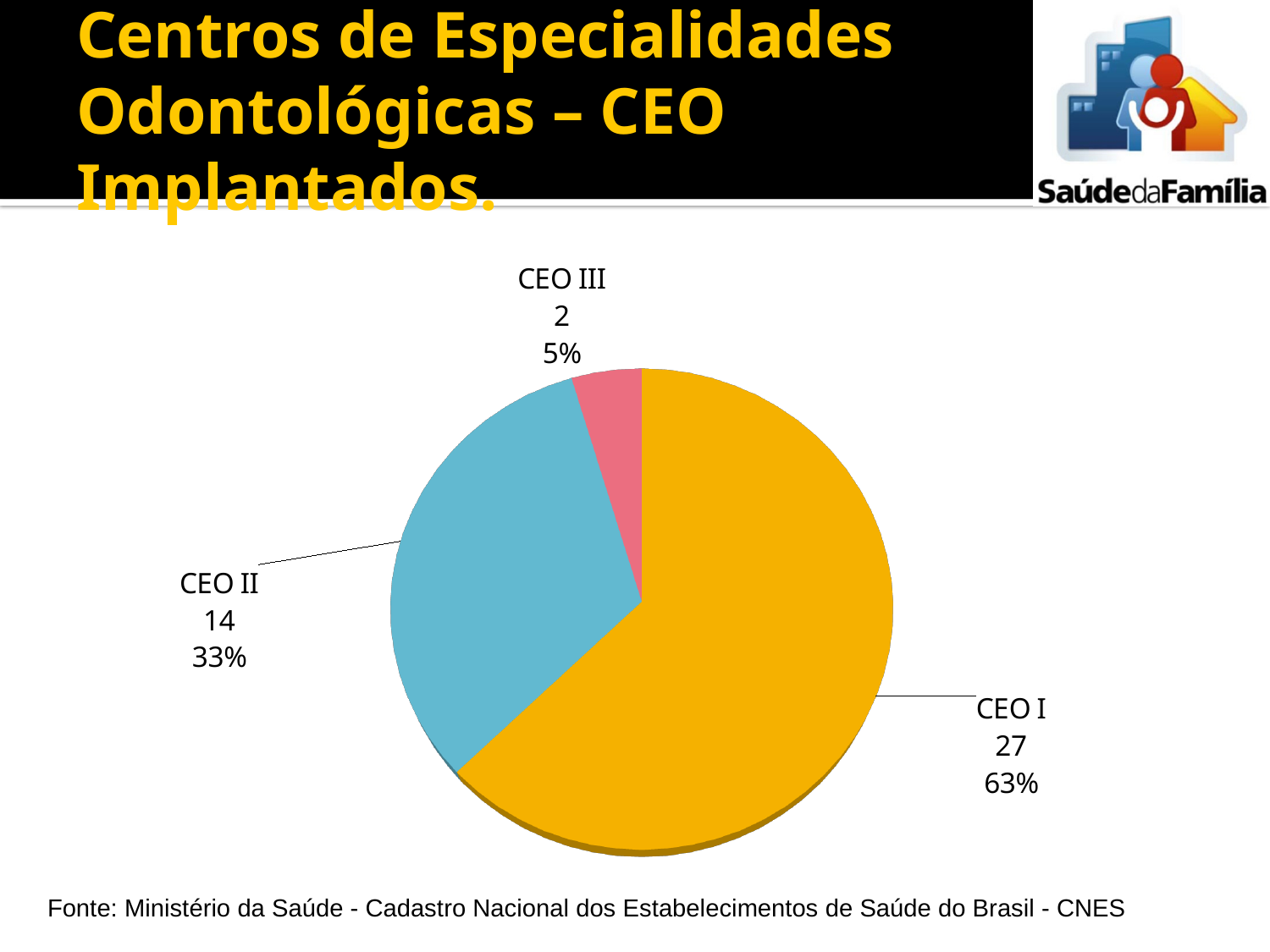
What is the value for CEO II? 14 How many slices does the pie chart have? 3 What is the value for CEO I? 27 Which is larger, the value for CEO II or CEO III? CEO II What is the value for CEO III? 2 What kind of chart is shown on the slide? pie chart Which category has the largest slice? CEO I What is the difference between the values for CEO I and CEO II? 13 What colour is the CEO II slice? blue Which category has the smallest slice? CEO III What share of the pie does CEO II represent? 33% What share of the pie does CEO I represent? 63%